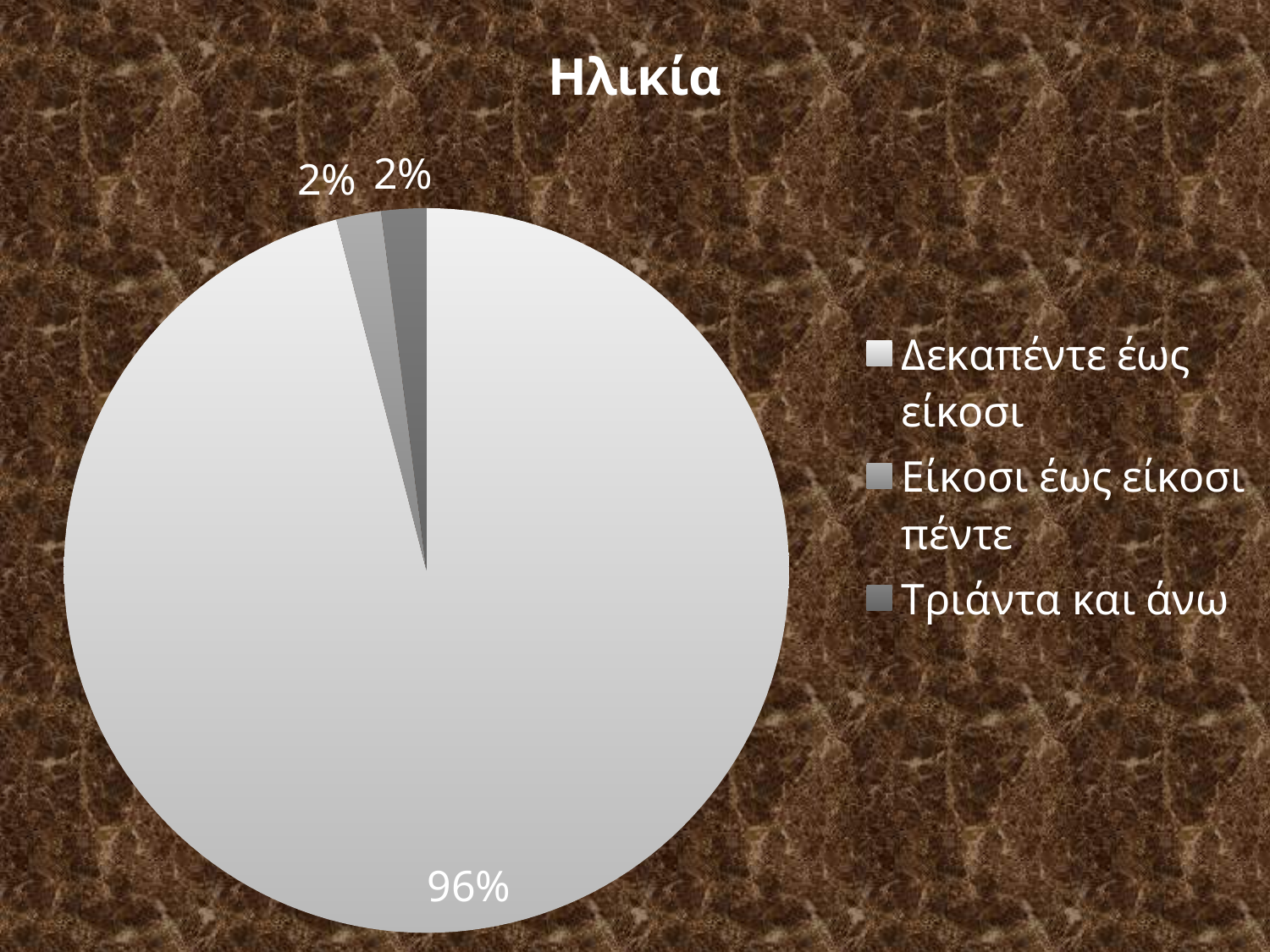
Which category has the largest slice of the pie? Δεκαπέντε έως είκοσι What is the difference between the 'Δεκαπέντε έως είκοσι' share and the 'Τριάντα και άνω' share? 94% What is the combined share of the 'Είκοσι έως είκοσι πέντε' and 'Τριάντα και άνω' slices? 4% What share of the pie does the 'Είκοσι έως είκοσι πέντε' slice represent? 2% How many slices does the pie chart have? 3 How many entries does the legend list? 3 What kind of chart is shown on the slide? pie chart Which legend entry is shown with the darkest grey colour? Τριάντα και άνω Which is larger, the 'Δεκαπέντε έως είκοσι' slice or the 'Είκοσι έως είκοσι πέντε' slice? Δεκαπέντε έως είκοσι What is the title of the chart? Ηλικία What share of the pie does the 'Δεκαπέντε έως είκοσι' slice represent? 96% What share of the pie does the 'Τριάντα και άνω' slice represent? 2%